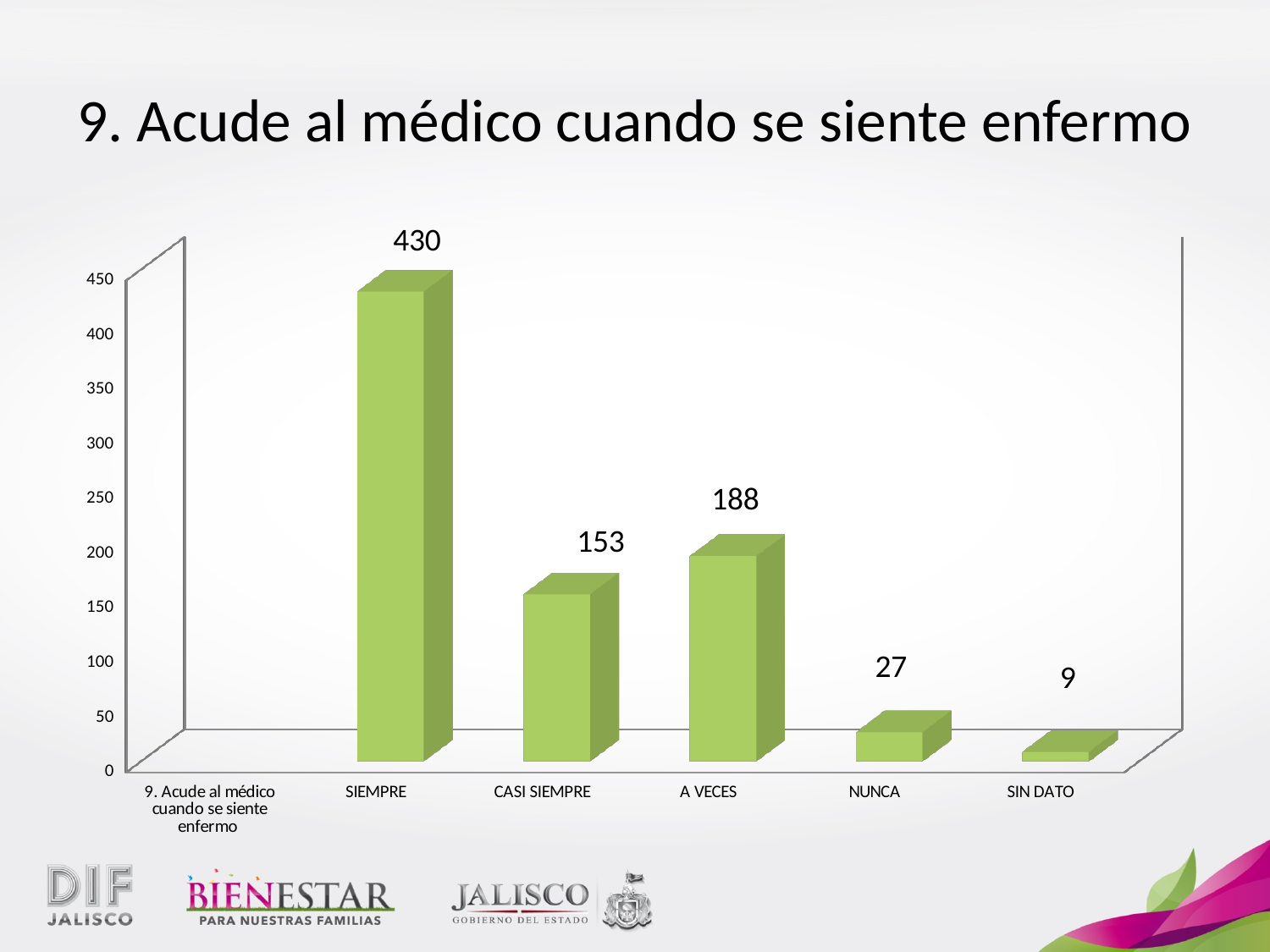
What is the value for A VECES? 188 Which category has the lowest value? SIN DATO What kind of chart is shown on the slide? bar chart What is the difference between the values for SIEMPRE and A VECES? 242 What is the title of the slide? 9. Acude al médico cuando se siente enfermo Is the value for NUNCA greater or less than 50? less Which is larger, the value for CASI SIEMPRE or the value for A VECES? A VECES What is the value for SIEMPRE? 430 What is the value for CASI SIEMPRE? 153 Which category has the highest value? SIEMPRE What is the value for SIN DATO? 9 What is the value for NUNCA? 27